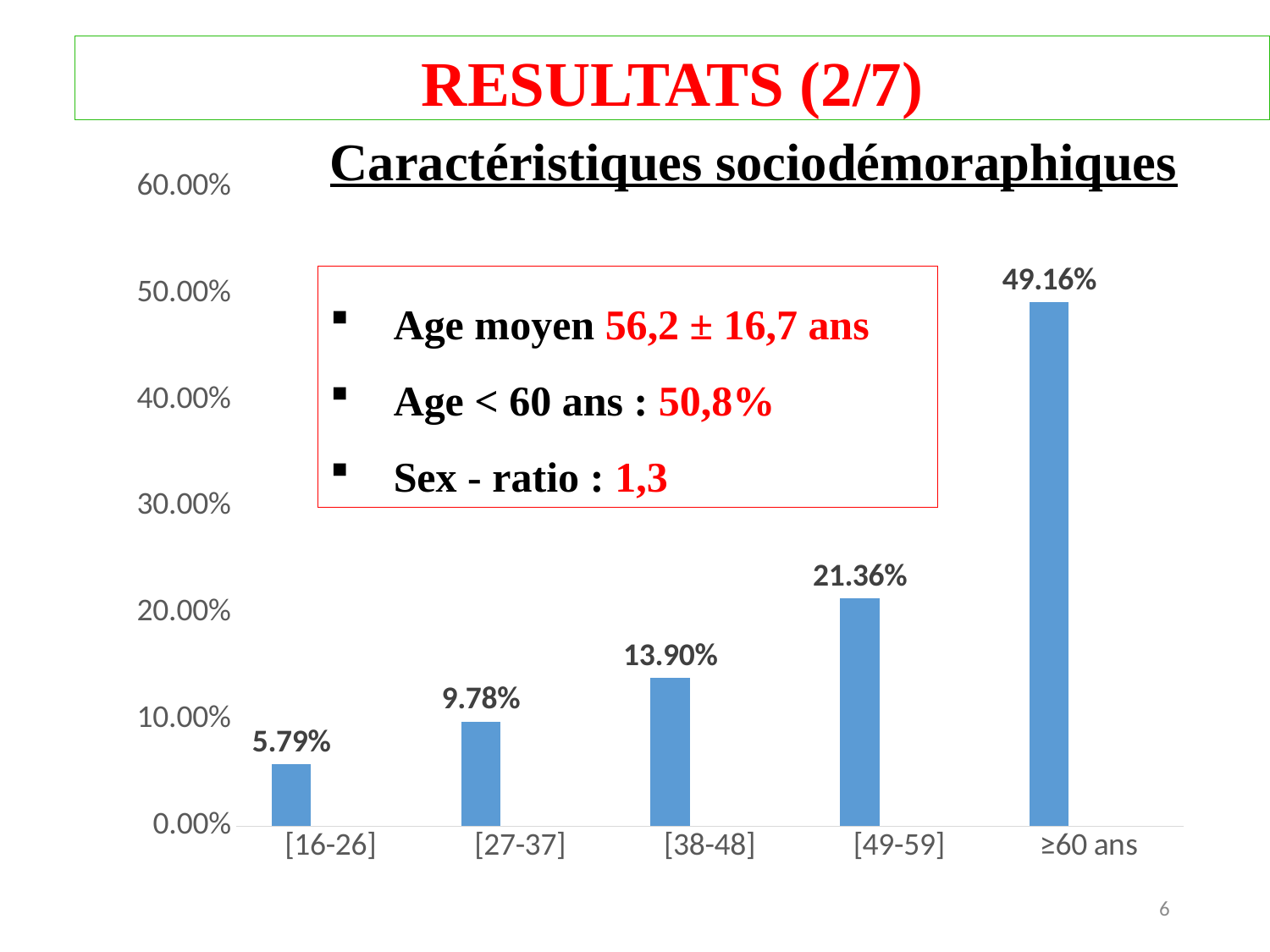
Which is larger, the value for [38-48] or the value for [27-37]? [38-48] What is the value for the [16-26] age group? 5.79% Which age group has the lowest value? [16-26] What kind of chart is shown on the slide? bar chart What is the value for the ≥60 ans age group? 49.16% Do the values rise or fall from [16-26] to ≥60 ans? rise Which age group has the highest value? ≥60 ans Is the value for [49-59] greater or less than 20.00%? greater What is the difference between the values for ≥60 ans and [49-59]? 27.80% How many age groups are shown on the x axis? 5 What is the value for the [38-48] age group? 13.90% What is the difference between the values for [27-37] and [16-26]? 3.99%